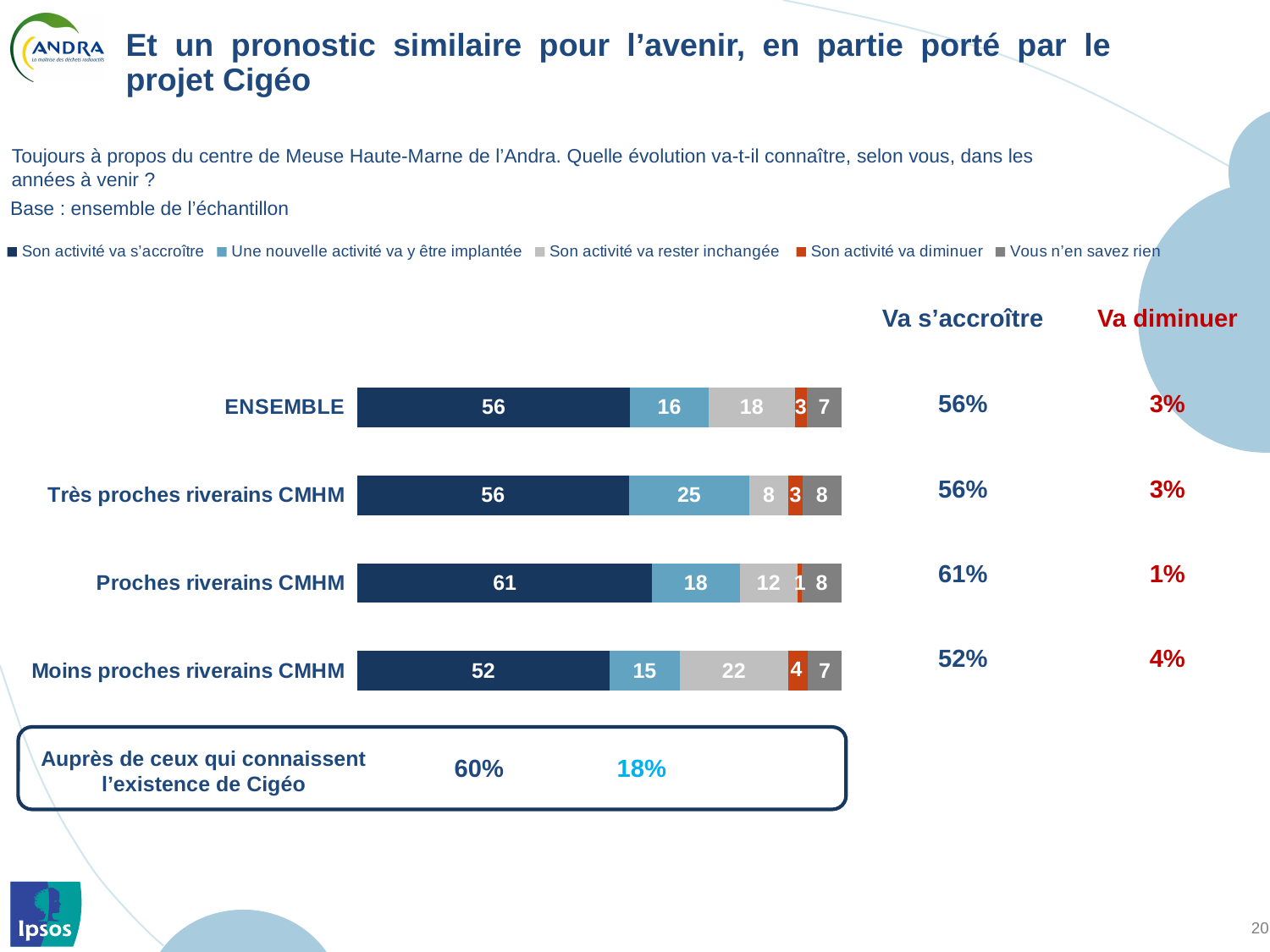
How many series does the legend list? 5 Which is larger: the 'Son activité va rester inchangée' value for ENSEMBLE or for Très proches riverains CMHM? ENSEMBLE What is the value of 'Une nouvelle activité va y être implantée' for Très proches riverains CMHM? 25 What is the value of 'Vous n'en savez rien' for ENSEMBLE? 7 Which category has the lowest value for 'Son activité va diminuer'? Proches riverains CMHM How many categories (bars) are plotted in the chart? 4 What is the value of 'Son activité va s'accroître' for Proches riverains CMHM? 61 What is the total of the stacked bar for Très proches riverains CMHM? 100 What is the value of 'Son activité va rester inchangée' for Moins proches riverains CMHM? 22 What is the difference between the 'Son activité va s'accroître' values for Proches riverains CMHM and Moins proches riverains CMHM? 9 What kind of chart is shown on the slide? Stacked bar chart Which category has the highest value for 'Son activité va s'accroître'? Proches riverains CMHM